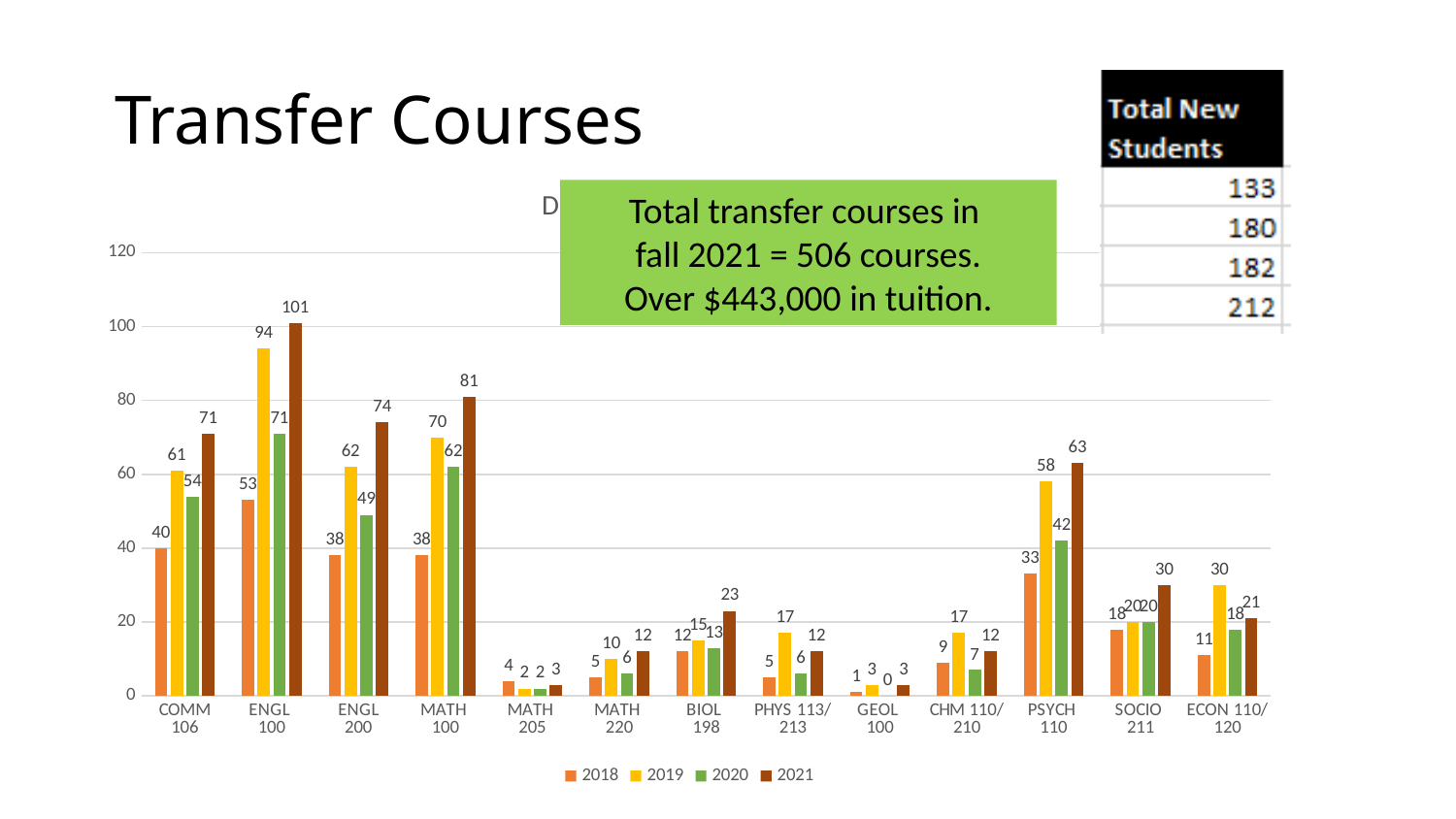
What is the 2021 value for ENGL 100? 101 Which course has the highest 2021 value? ENGL 100 How many series does the legend list? 4 What kind of chart is shown on the slide? Bar chart What is the 2019 value for PSYCH 110? 58 Which course has the lowest 2020 value? GEOL 100 What is the 2018 value for MATH 100? 38 What is the total of the four values for BIOL 198? 63 How many courses are shown on the x axis? 13 Is the 2019 value for MATH 100 greater or less than 60? greater Which is larger for ECON 110/120: the 2019 value or the 2021 value? 2019 What is the difference between the 2021 and 2018 values for COMM 106? 31